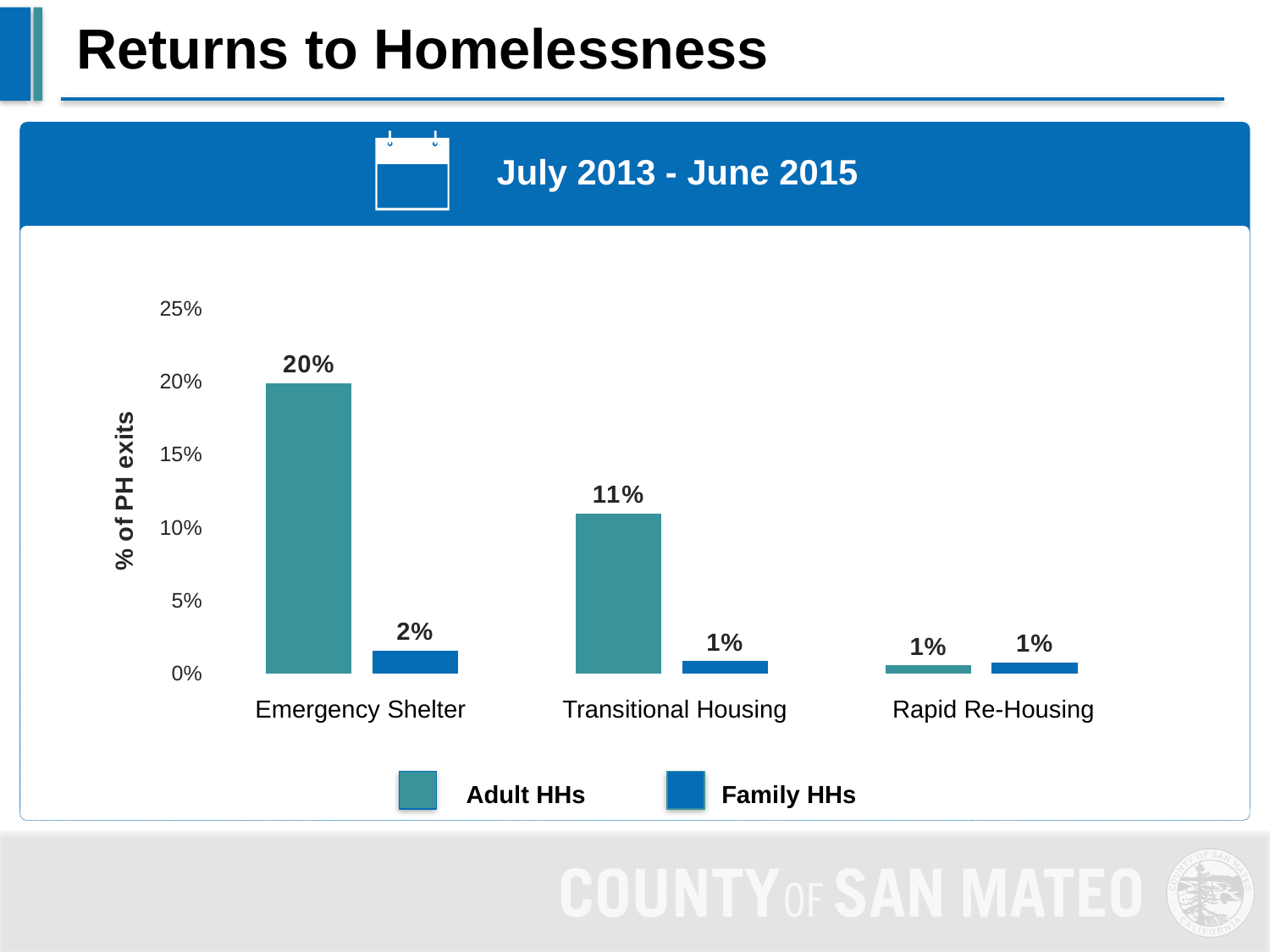
Which is larger: Adult HHs in Transitional Housing or Family HHs in Emergency Shelter? Adult HHs in Transitional Housing What is the value for Family HHs in Transitional Housing? 1% What is the value for Family HHs in Emergency Shelter? 2% What is the difference between Adult HHs in Emergency Shelter and Adult HHs in Transitional Housing? 9% What is the value for Adult HHs in Rapid Re-Housing? 1% What is the value for Adult HHs in Emergency Shelter? 20% How many categories are shown on the x axis? 3 What is the difference between Adult HHs and Family HHs in Emergency Shelter? 18% Which category has the lowest value for Adult HHs? Rapid Re-Housing What kind of chart is shown on the slide? Bar chart Which category has the highest value for Adult HHs? Emergency Shelter How many series does the legend list? 2